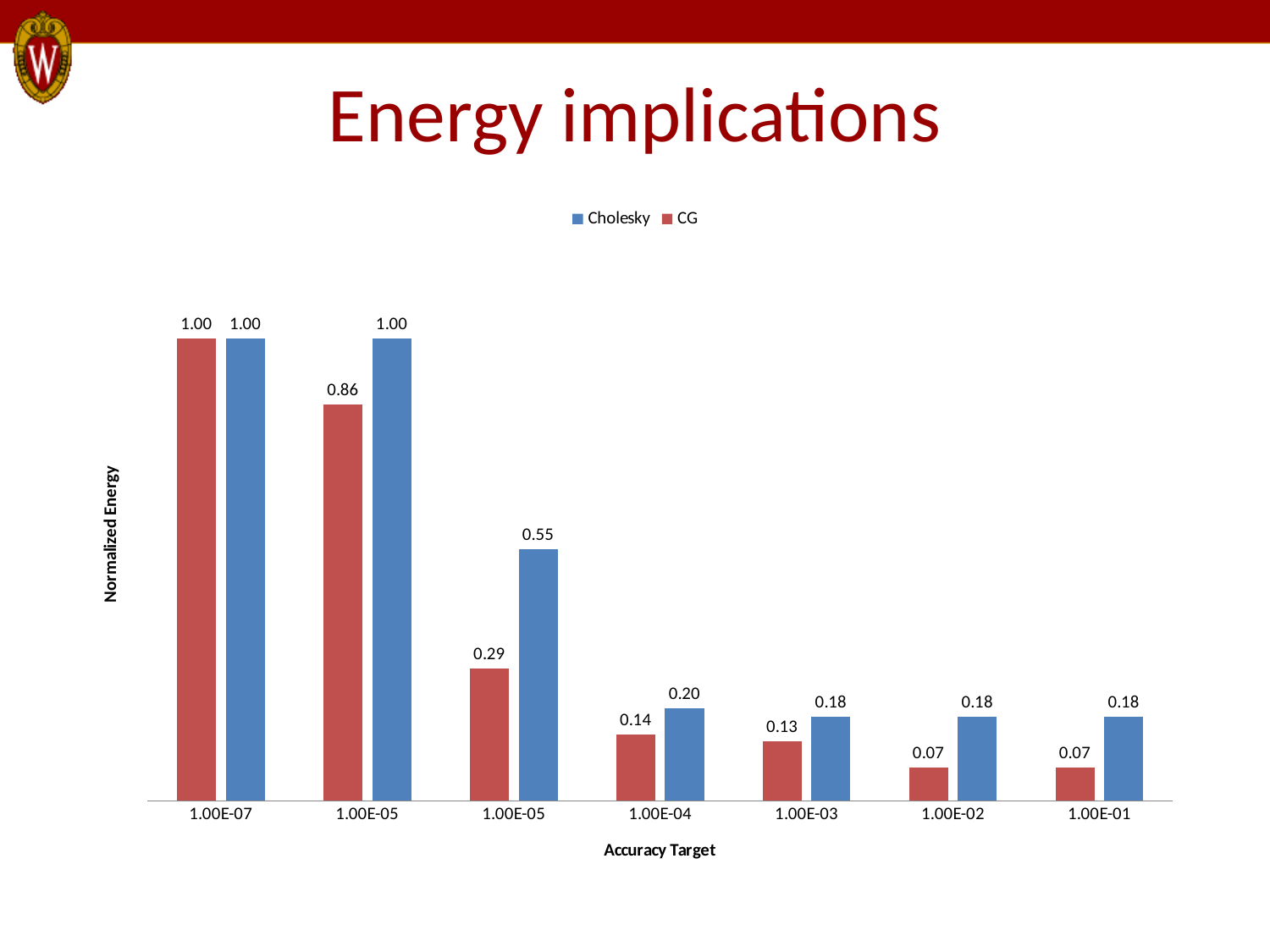
What is the Normalized Energy value for Cholesky at the 1.00E-03 accuracy target? 0.18 At which accuracy target does CG have its highest Normalized Energy? 1.00E-07 How many series does the legend list? 2 Do the Cholesky values generally rise or fall moving from left to right along the x axis? Fall What is the Normalized Energy value for CG at the 1.00E-04 accuracy target? 0.14 How many accuracy target categories are shown on the x axis? 7 What is the Normalized Energy value for Cholesky at the 1.00E-07 accuracy target? 1.00 What is the difference between the Cholesky and CG values at the 1.00E-03 accuracy target? 0.05 What is the difference between the Cholesky and CG values at the 1.00E-04 accuracy target? 0.06 What kind of chart is shown on the slide? Bar chart What is the Normalized Energy value for CG at the 1.00E-01 accuracy target? 0.07 At the 1.00E-02 accuracy target, which series has the larger Normalized Energy, Cholesky or CG? Cholesky